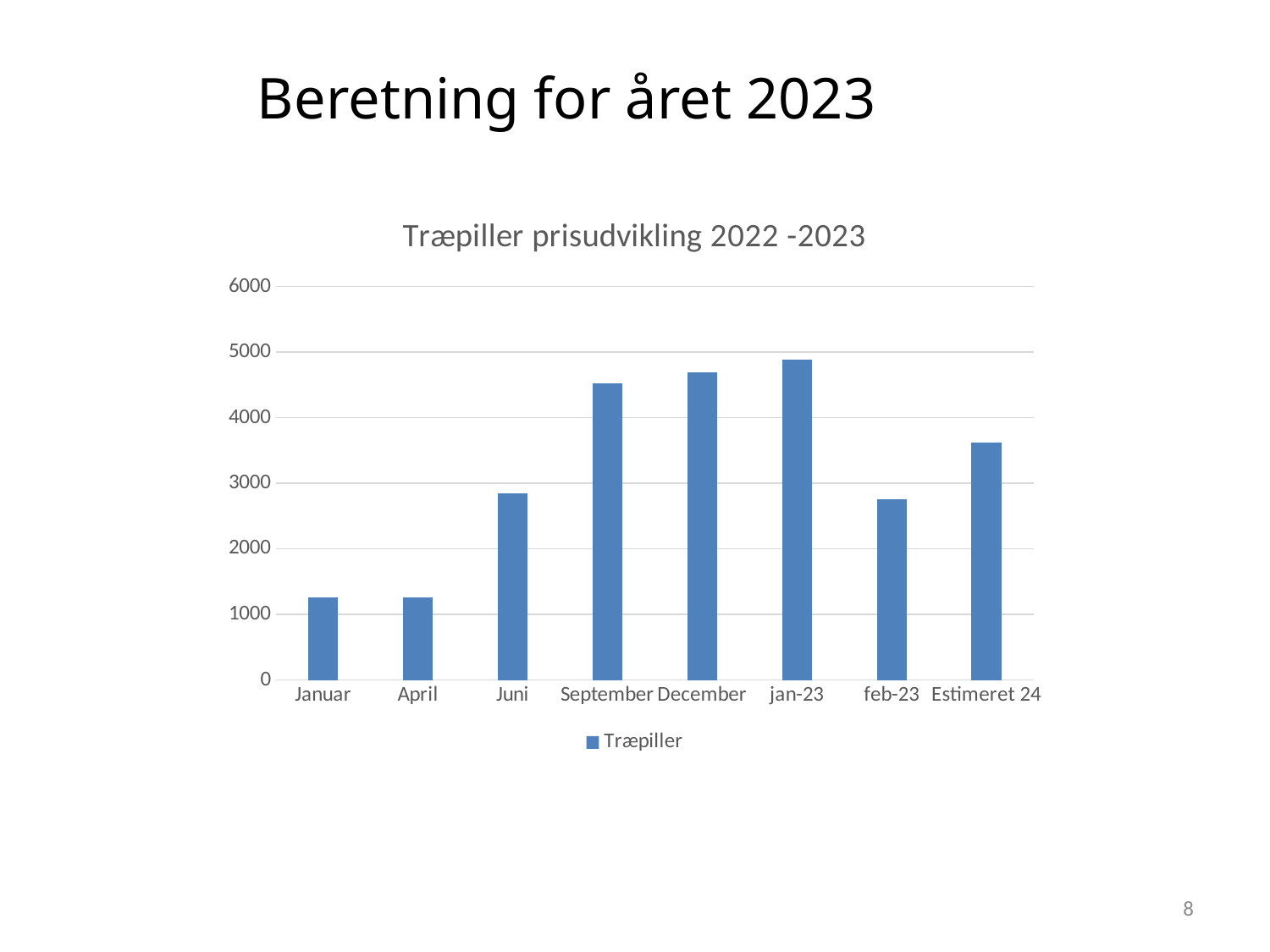
What is the title of the chart? Træpiller prisudvikling 2022 -2023 Which category has the highest value? jan-23 What type of chart is shown on the slide? bar chart Is the value for September greater or less than 4000? greater Is the value for Juni greater or less than 3000? less How many series does the legend list? 1 How many categories are shown on the x axis of the chart? 8 Is the value for feb-23 greater or less than 3000? less Which is larger, the value for September or the value for Juni? September Do the values rise or fall from Januar to jan-23? rise What is the name of the series shown in the legend? Træpiller